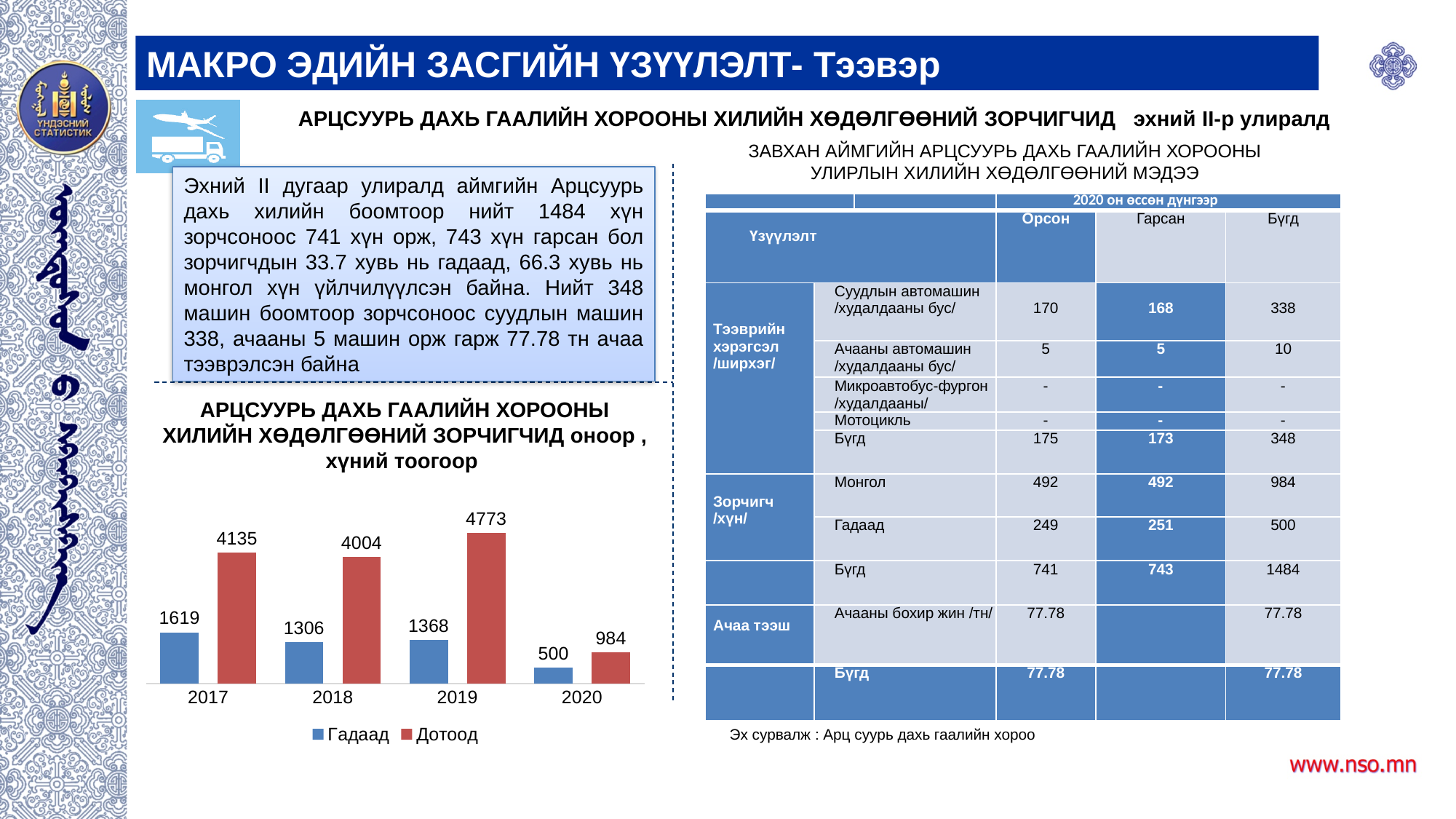
What is the value for Гадаад in 2017? 1619 What is the difference between the Дотоод and Гадаад values in 2017? 2516 In which year is the Гадаад value lowest? 2020 How many series does the chart legend list? 2 In which year is the Дотоод value highest? 2019 Which series is shown in red in the chart? Дотоод What kind of chart is shown on the slide? bar chart Which is larger, the Гадаад value in 2018 or the Гадаад value in 2019? 2019 How many years are shown on the x axis of the chart? 4 What is the value for Гадаад in 2020? 500 What is the value for Дотоод in 2019? 4773 What is the value for Дотоод in 2018? 4004